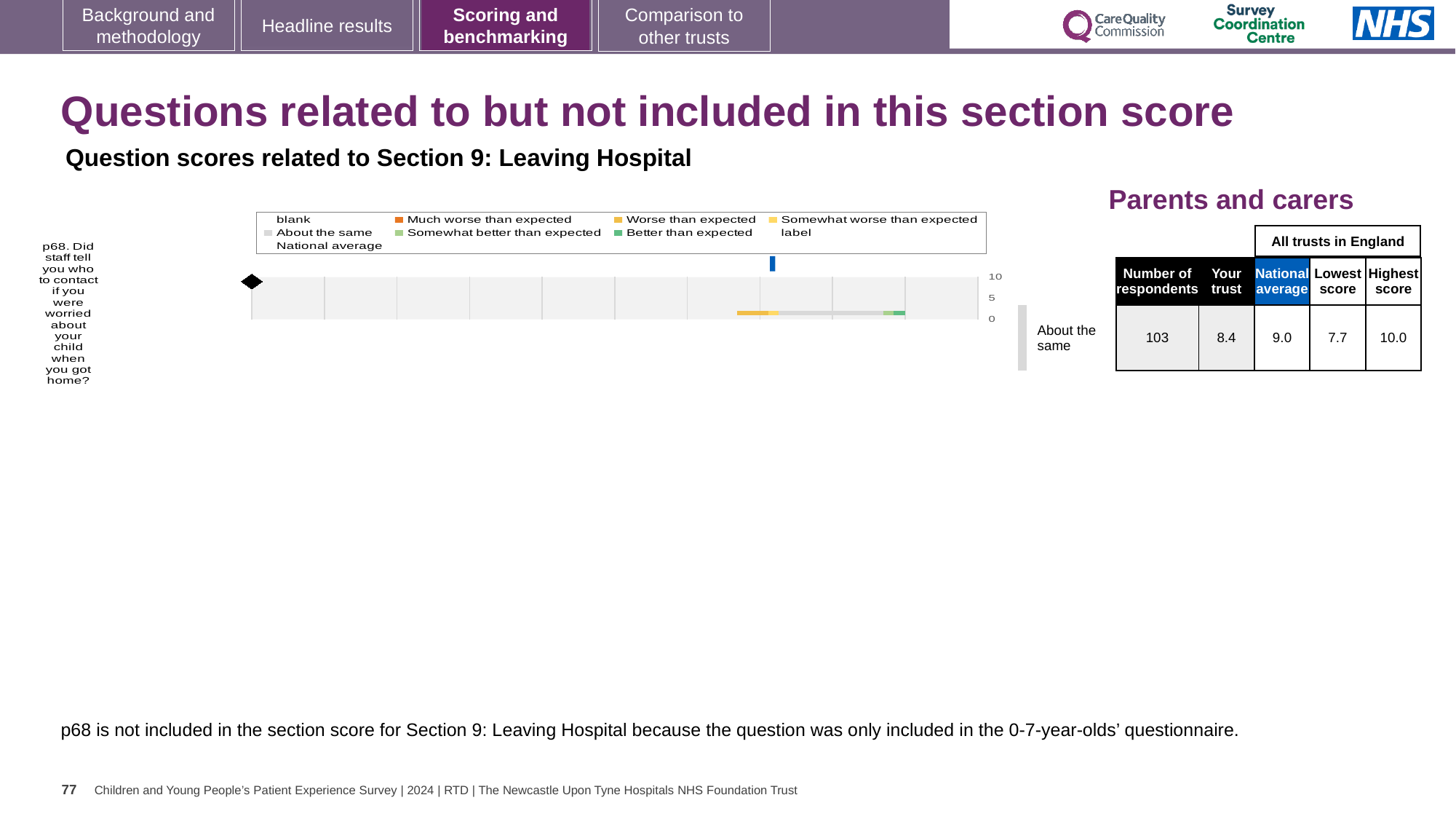
In the table next to the chart, what is the 'Your trust' score for p68? 8.4 What is the difference between the National average (9.0) and the 'Your trust' score (8.4) for p68? 0.6 What is the difference between the Highest score (10.0) and the Lowest score (7.7) for p68? 2.3 How many questions (categories) are plotted in the chart? 1 Which question is plotted in the chart? p68. Did staff tell you who to contact if you were worried about your child when you got home? What benchmark category label is shown to the right of the chart for p68? About the same Which is larger for p68, the 'Your trust' score or the National average? National average In the table next to the chart, what is the Highest score across all trusts in England for p68? 10.0 In the table next to the chart, what is the National average score for p68? 9.0 In the table next to the chart, how many respondents answered p68? 103 In the table next to the chart, what is the Lowest score across all trusts in England for p68? 7.7 What kind of chart is shown on the slide? bar chart